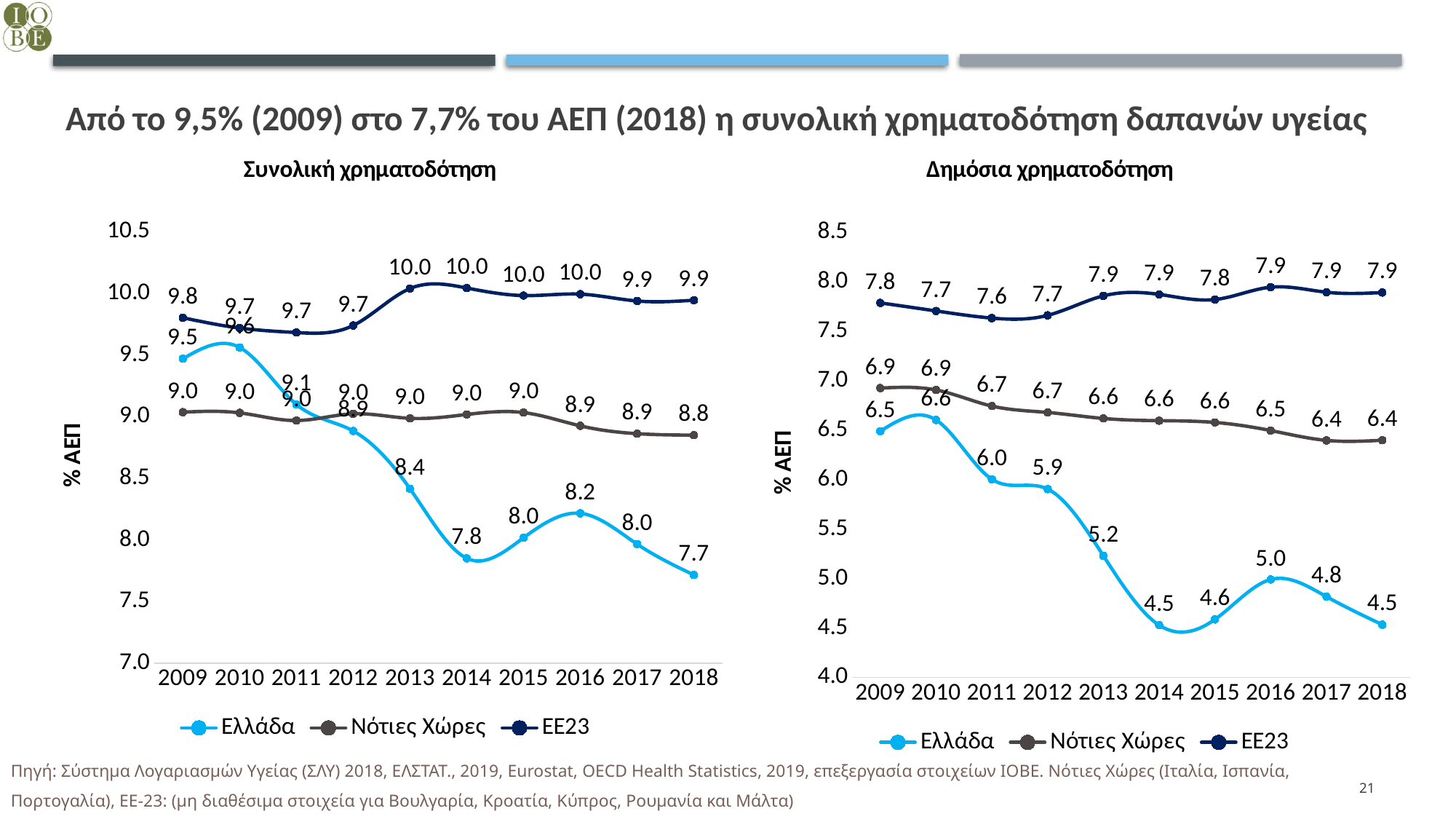
In the 'Συνολική χρηματοδότηση' chart, what is the difference between the ΕΕ23 and Ελλάδα values in 2018? 2.2 In the 'Δημόσια χρηματοδότηση' chart, does the Ελλάδα line overall rise or fall from 2009 to 2018? fall In the 'Δημόσια χρηματοδότηση' chart, what is the value for ΕΕ23 in 2011? 7.6 In the 'Συνολική χρηματοδότηση' chart, what is the value for Ελλάδα in 2018? 7.7 In the 'Συνολική χρηματοδότηση' chart, what is the value for ΕΕ23 in 2013? 10.0 In the 'Συνολική χρηματοδότηση' chart, what is the value for Νότιες Χώρες in 2018? 8.8 In the 'Δημόσια χρηματοδότηση' chart, which series has the higher value in 2016, Ελλάδα or Νότιες Χώρες? Νότιες Χώρες What type of chart is the 'Δημόσια χρηματοδότηση' chart? line chart How many series does the legend of the 'Συνολική χρηματοδότηση' chart list? 3 In the 'Δημόσια χρηματοδότηση' chart, what is the value for Ελλάδα in 2014? 4.5 In the 'Δημόσια χρηματοδότηση' chart, what is the value for Νότιες Χώρες in 2009? 6.9 In the 'Συνολική χρηματοδότηση' chart, in which year is the Ελλάδα value lowest? 2018